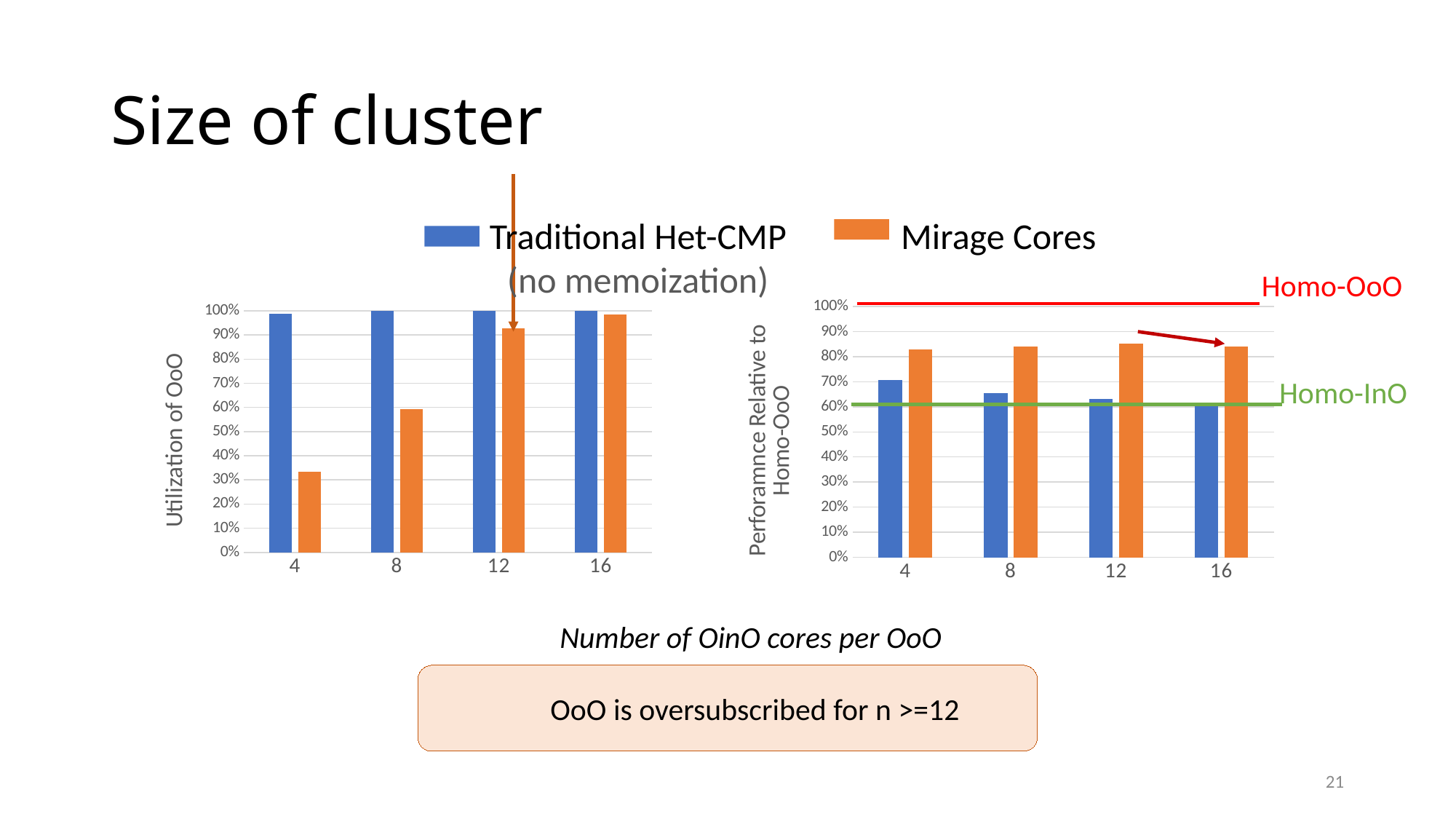
In the left chart (Utilization of OoO), do the Mirage Cores values rise or fall as the number of OinO cores per OoO increases? rise In the left chart (Utilization of OoO), which category has the lowest Mirage Cores value? 4 How many categories are shown on the x axis of the right chart (Performance Relative to Homo-OoO)? 4 In the right chart (Performance Relative to Homo-OoO), which category has the highest Traditional Het-CMP value? 4 In the left chart (Utilization of OoO), is the Mirage Cores value at 8 greater or less than 50%? greater How many series does the legend list? 2 In the right chart (Performance Relative to Homo-OoO), which is larger at 4: Traditional Het-CMP or Mirage Cores? Mirage Cores What label is attached to the red horizontal line at 100% in the right chart? Homo-OoO In the left chart (Utilization of OoO), is the Mirage Cores value at 4 greater or less than 40%? less What kind of chart is the left chart (Utilization of OoO)? bar chart In the right chart (Performance Relative to Homo-OoO), is the Traditional Het-CMP value at 4 greater or less than 60%? greater In the right chart (Performance Relative to Homo-OoO), do the Traditional Het-CMP values rise or fall as the number of OinO cores per OoO increases? fall